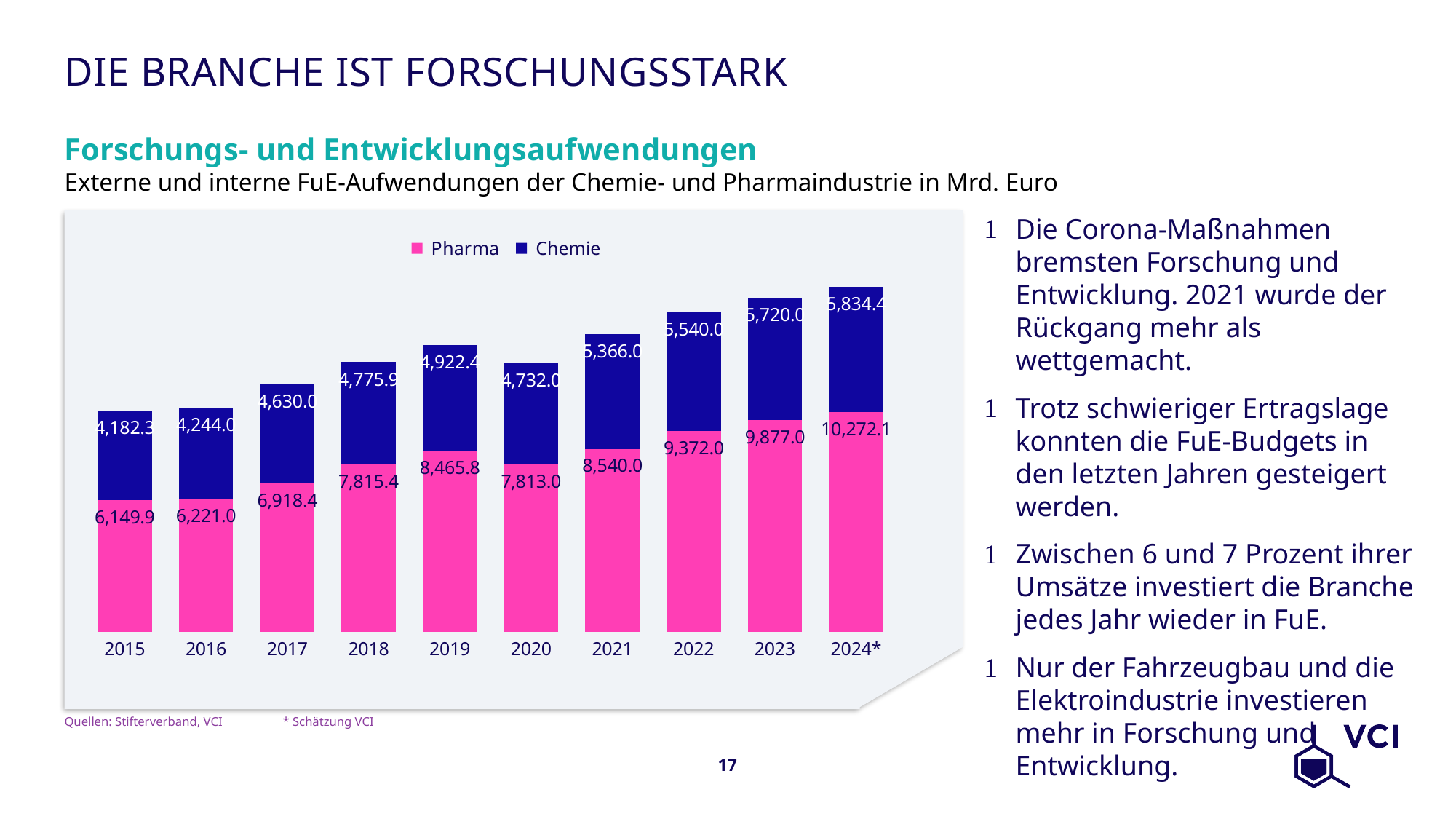
What is the total of the stacked bar for 2015? 10,332.2 Which is larger, the Pharma value for 2019 or the Pharma value for 2020? 2019 How many years are shown on the x axis? 10 What kind of chart is shown on the slide? Stacked bar chart What is the difference between the Chemie value for 2023 and the Chemie value for 2022? 180.0 Which year has the lowest Pharma value? 2015 What is the Pharma value for 2024*? 10,272.1 How many series does the legend list? 2 What is the Pharma value for 2019? 8,465.8 What is the Chemie value for 2021? 5,366.0 What is the difference between the Pharma value for 2024* and the Pharma value for 2015? 4,122.2 Which year has the highest Chemie value? 2024*